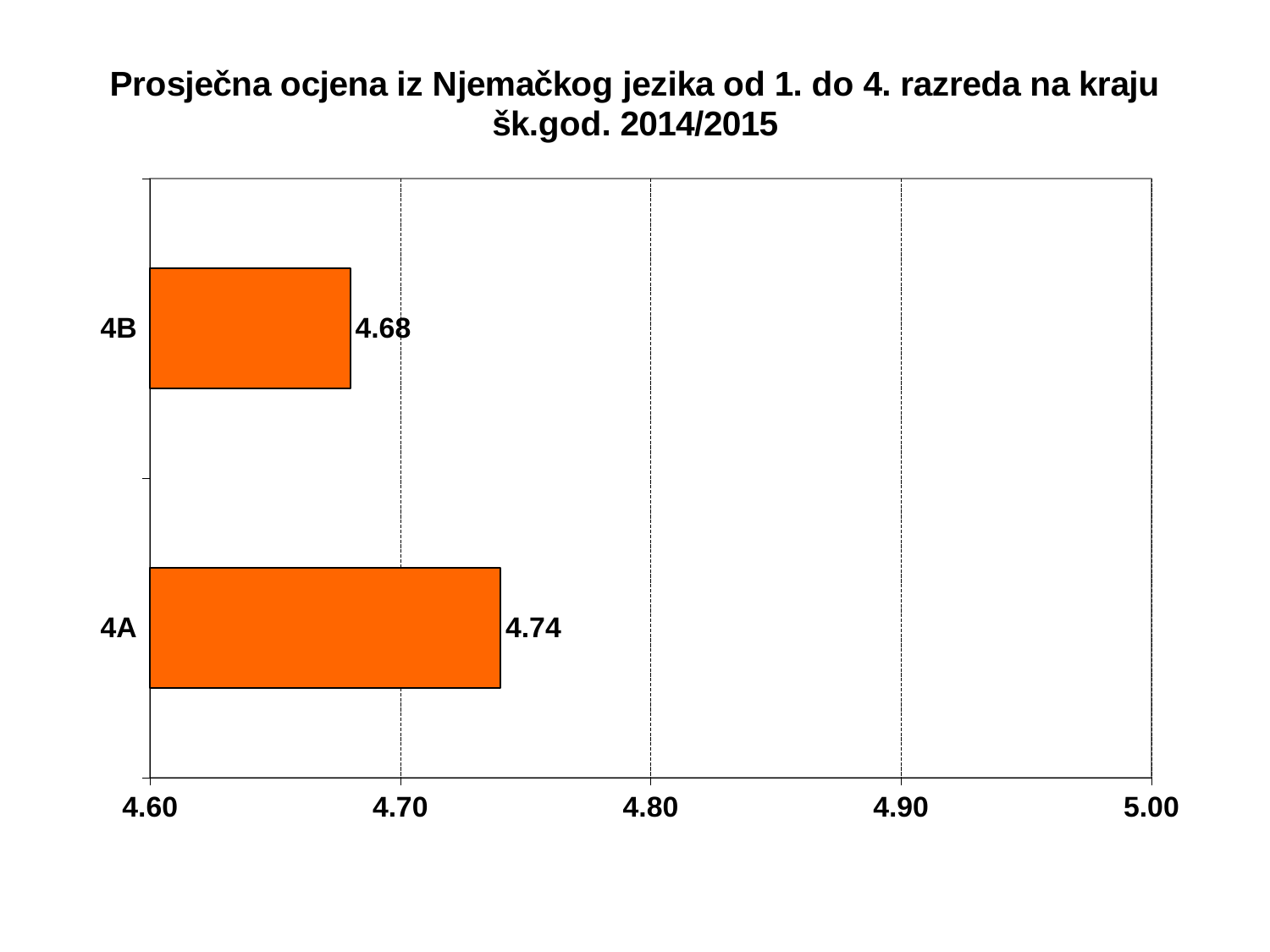
Which category has the lowest value? 4B What kind of chart is shown on the slide? bar chart What is the title of the chart? Prosječna ocjena iz Njemačkog jezika od 1. do 4. razreda na kraju šk.god. 2014/2015 Which category has the highest value? 4A What is the difference between the values for 4A and 4B? 0.06 Which is larger, the value for 4A or the value for 4B? 4A What is the value for 4A? 4.74 Is the value for 4B greater or less than 4.70? less What colour are the bars in the chart? orange How many categories are shown in the chart? 2 What is the value for 4B? 4.68 Is the value for 4A greater or less than 4.70? greater